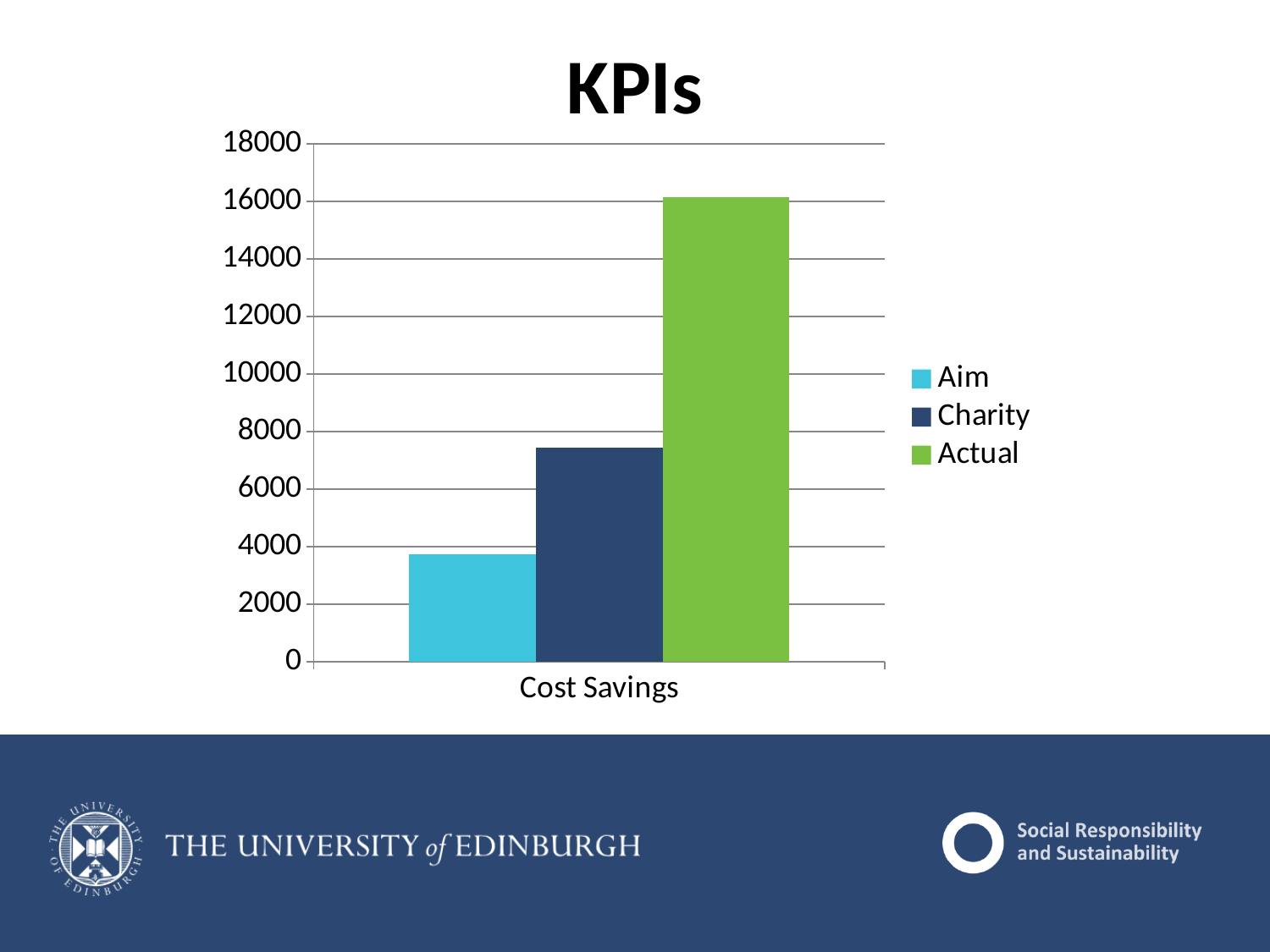
Is the value for Charity greater or less than 6000? greater What is the category label on the x axis? Cost Savings What kind of chart is shown on the slide? bar chart Which is larger for Cost Savings, Aim or Charity? Charity Which series has the highest value for Cost Savings? Actual Is the value for Actual greater or less than 14000? greater Is the value for Charity greater or less than 8000? less How many categories are shown on the x axis? 1 How many series does the legend list? 3 What is the title of the chart? KPIs Which series has the lowest value for Cost Savings? Aim